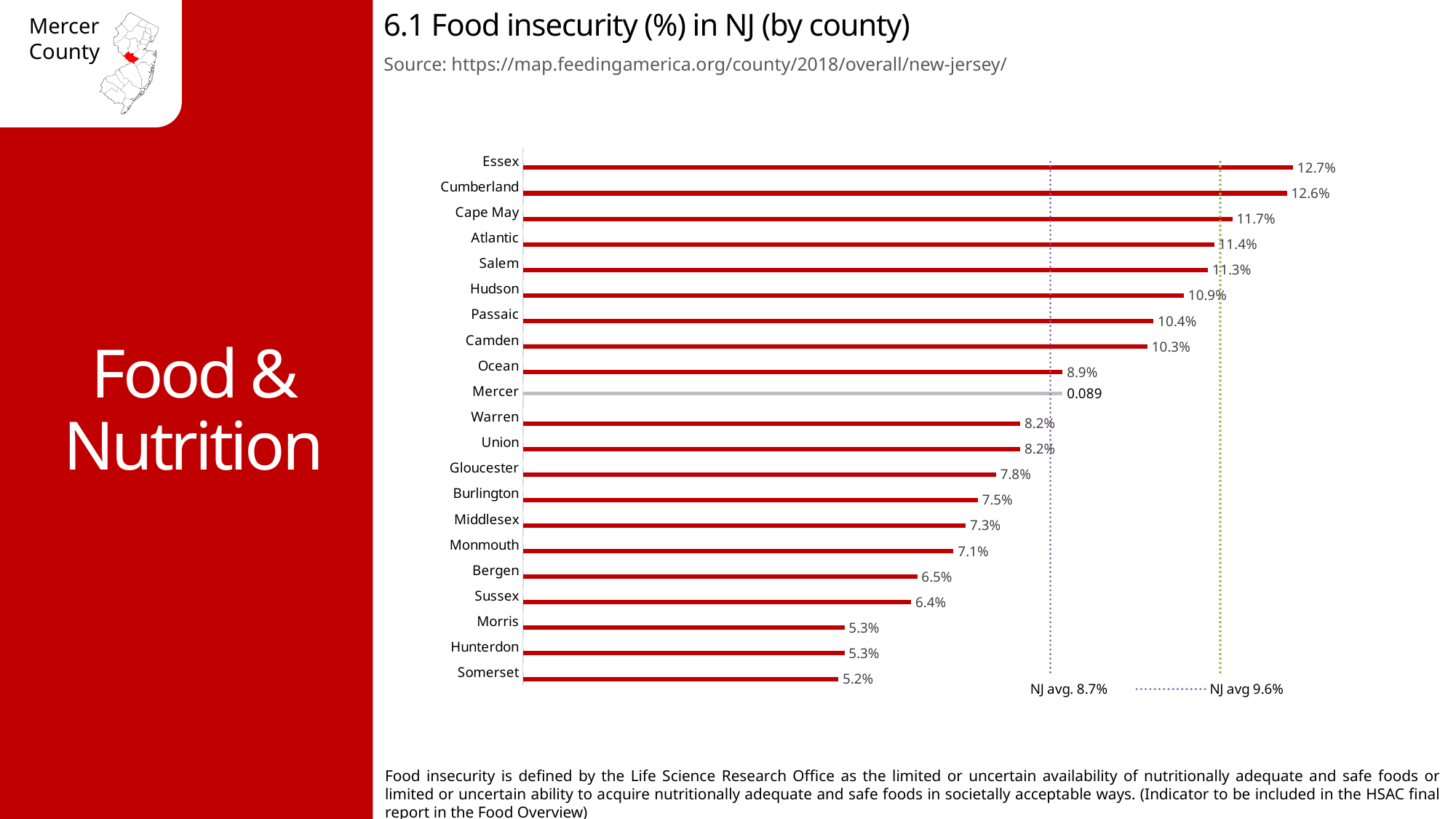
What value is printed next to the Mercer bar? 0.089 What is the difference between the values for Cape May (11.7%) and Atlantic (11.4%)? 0.3 percentage points Which county has the lowest food insecurity value on the chart? Somerset What is the food insecurity value for Camden county? 10.3% What kind of chart is shown on the slide? Bar chart Which county has a higher food insecurity value, Hudson or Passaic? Hudson What is the difference between the values for Essex (12.7%) and Somerset (5.2%)? 7.5 percentage points Which county's bar is drawn in grey instead of red? Mercer Which county has the highest food insecurity value on the chart? Essex What is the food insecurity value shown for Essex county? 12.7% Do the values rise or fall going down the chart from Essex to Somerset? Fall How many counties are listed on the chart? 21